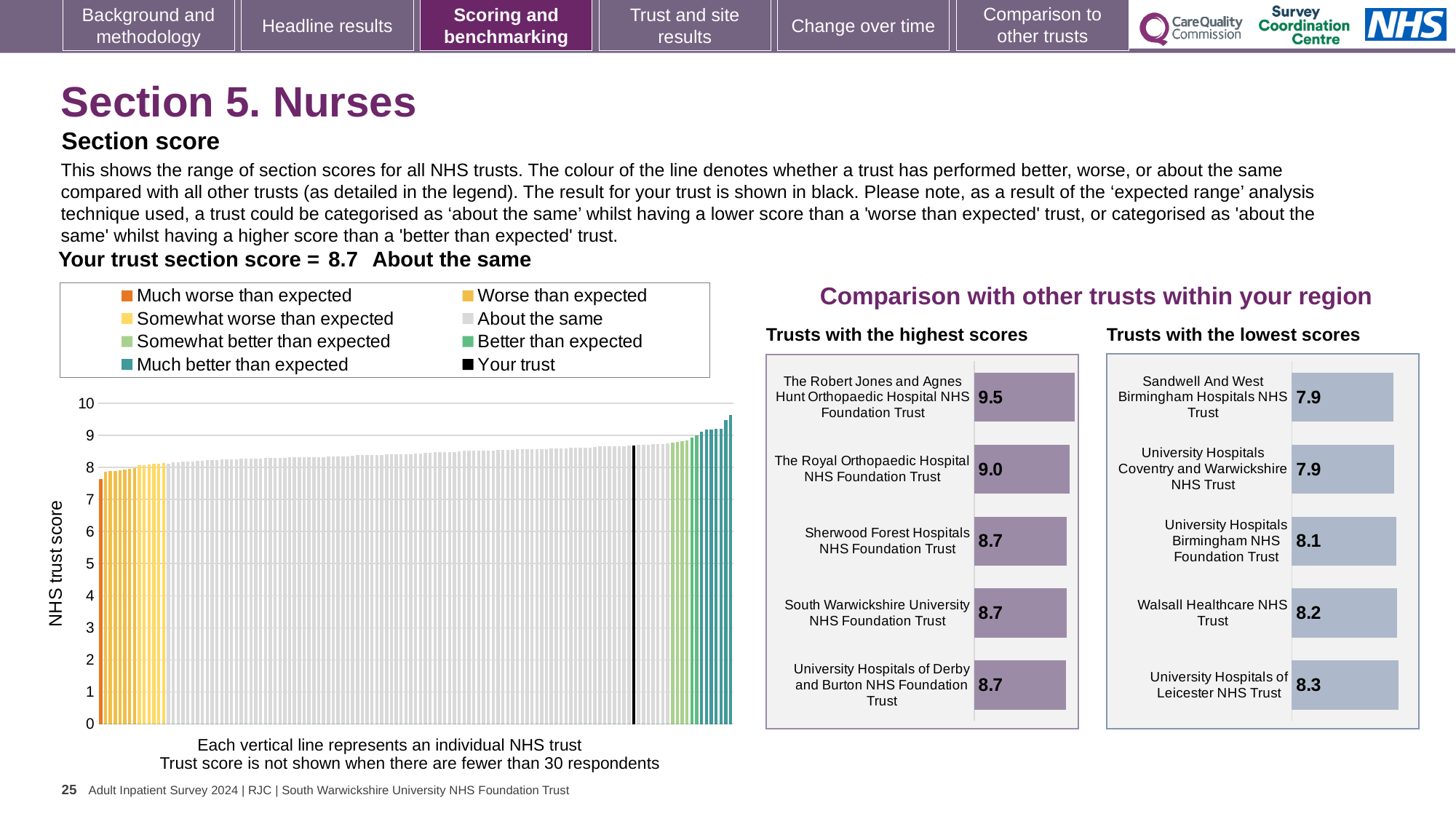
In the large chart on the left, is the value of the black 'Your trust' bar greater or less than 8? greater In the 'Trusts with the lowest scores' chart, which has the larger score: Walsall Healthcare NHS Trust or University Hospitals Birmingham NHS Foundation Trust? Walsall Healthcare NHS Trust What kind of chart is the large chart on the left showing NHS trust scores? Bar chart In the 'Trusts with the highest scores' chart, what is the score for The Royal Orthopaedic Hospital NHS Foundation Trust? 9.0 How many entries does the legend of the large chart on the left list? 8 In the 'Trusts with the lowest scores' chart, which trust has the highest score? University Hospitals of Leicester NHS Trust In the large chart on the left, do the bar values rise or fall from left to right? Rise In the 'Trusts with the lowest scores' chart, what is the difference between the scores of University Hospitals of Leicester NHS Trust and Sandwell And West Birmingham Hospitals NHS Trust? 0.4 In the 'Trusts with the highest scores' chart, what is the score for The Robert Jones and Agnes Hunt Orthopaedic Hospital NHS Foundation Trust? 9.5 How many trusts are shown in the 'Trusts with the highest scores' chart? 5 In the 'Trusts with the highest scores' chart, what is the difference between the scores of The Robert Jones and Agnes Hunt Orthopaedic Hospital NHS Foundation Trust and The Royal Orthopaedic Hospital NHS Foundation Trust? 0.5 In the 'Trusts with the lowest scores' chart, what is the score for Walsall Healthcare NHS Trust? 8.2